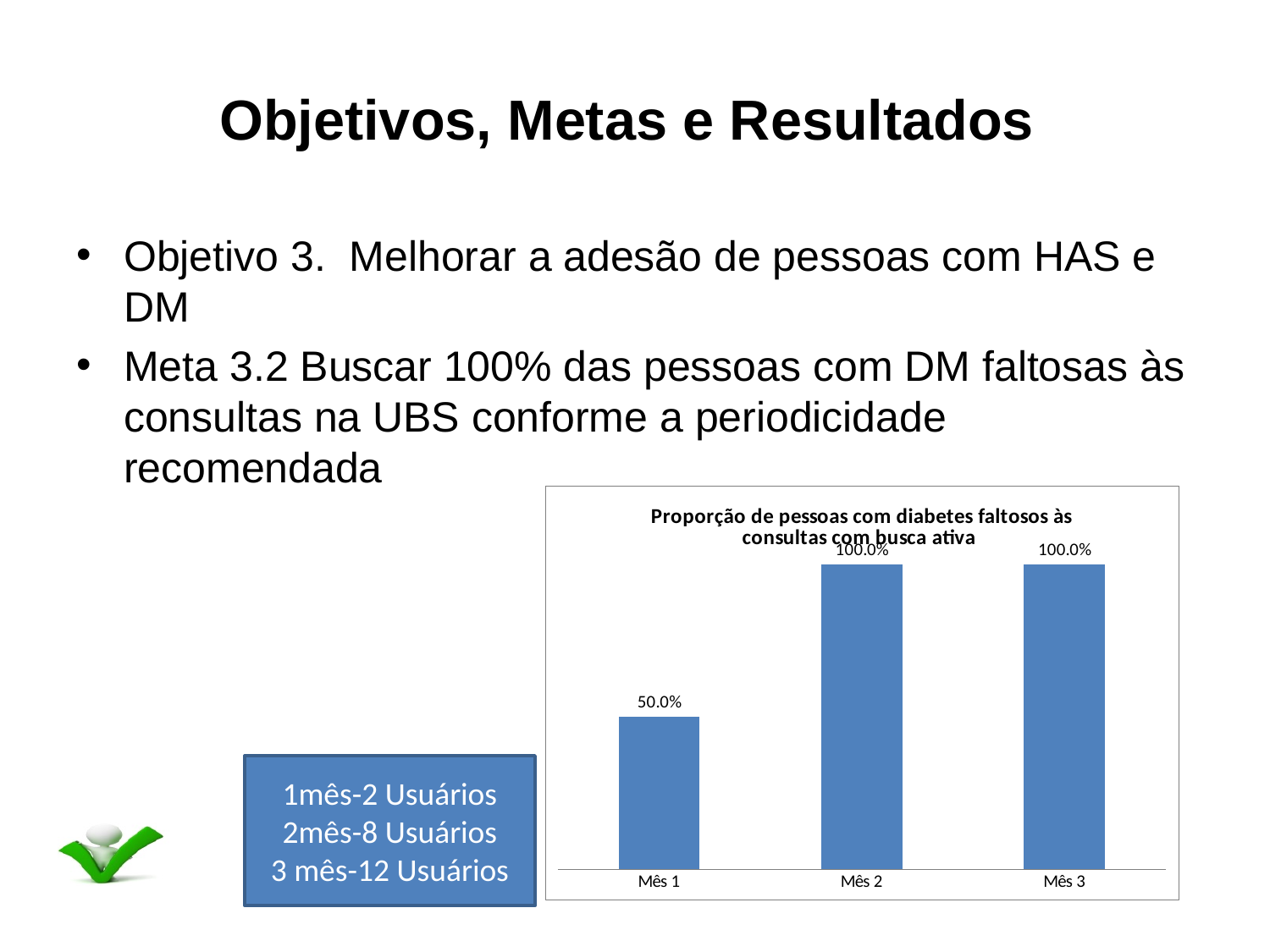
Which month has the lowest value? Mês 1 What is the value for Mês 1? 50.0% Which is larger, the value for Mês 1 or the value for Mês 3? Mês 3 How many months are shown on the x axis of the chart? 3 What is the value for Mês 3? 100.0% What is the title of the chart? Proporção de pessoas com diabetes faltosos às consultas com busca ativa What colour are the bars in the chart? blue Do the values rise or fall from Mês 1 to Mês 2? rise What is the value for Mês 2? 100.0% What kind of chart is shown on the slide? bar chart What is the difference between the values for Mês 2 and Mês 1? 50.0%